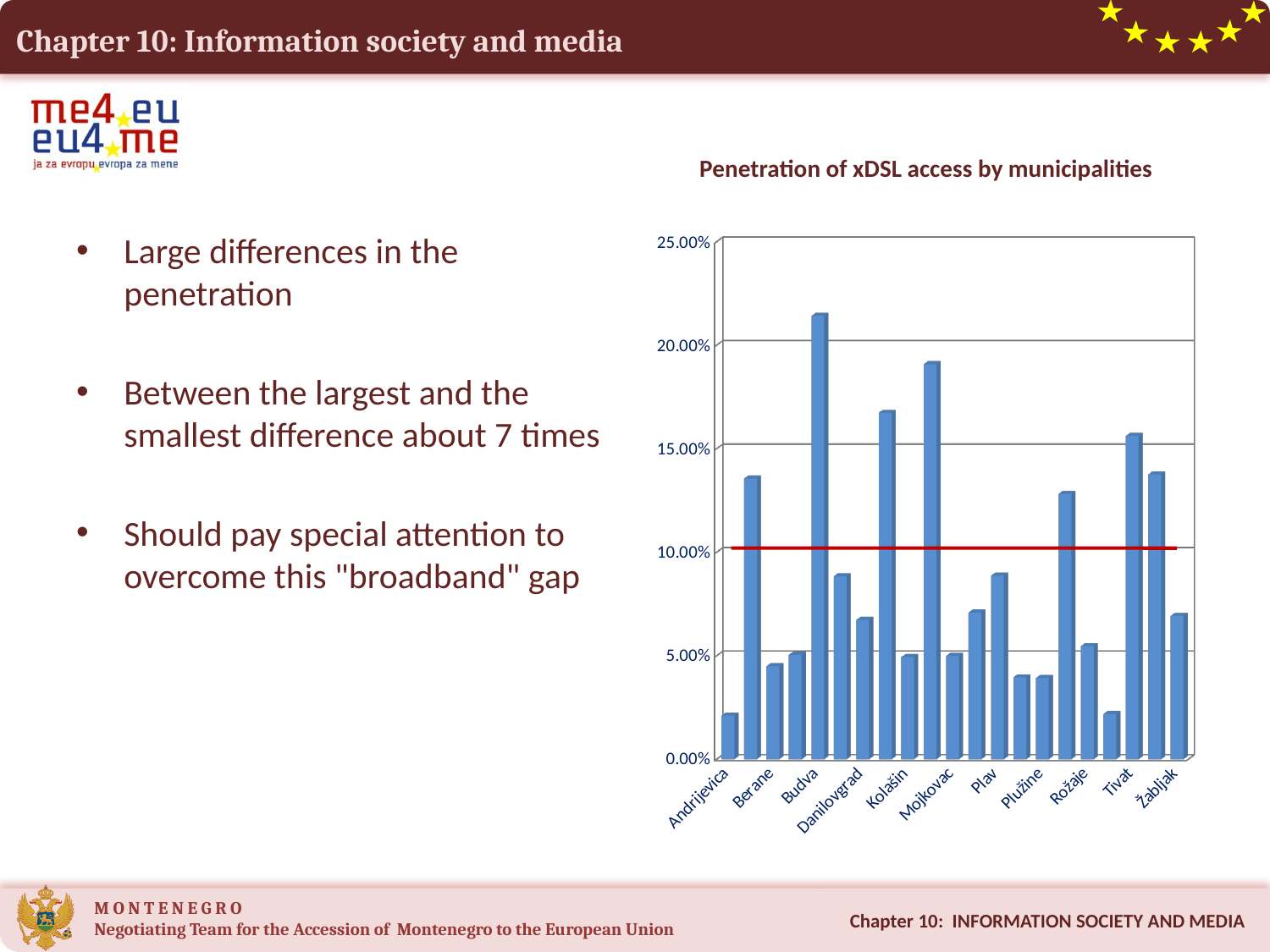
Is the value for Plužine greater or less than 5.00%? less Which has a higher xDSL penetration, Plav or Andrijevica? Plav What is the title of the chart? Penetration of xDSL access by municipalities Which has a higher xDSL penetration, Tivat or Berane? Tivat At what level on the y axis is the red horizontal line drawn across the chart? 10.00% Is the value for Tivat greater or less than 15.00%? greater Is the value for Plav greater or less than 10.00%? less Which municipality has the highest xDSL penetration in the chart? Budva What kind of chart is shown on the slide? Bar chart